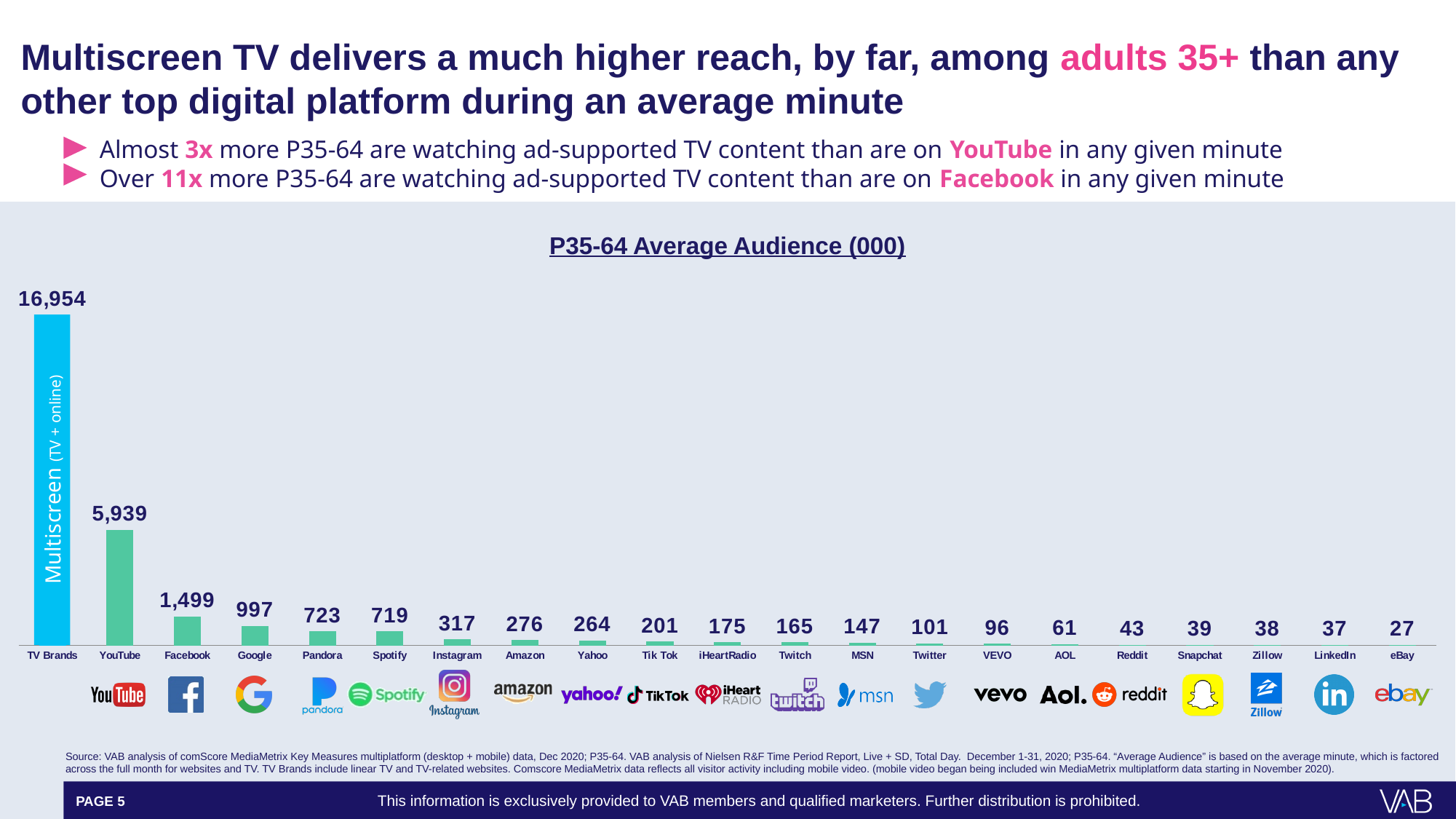
What is the title of the chart? P35-64 Average Audience (000) Which has a larger P35-64 average audience, Instagram or Amazon? Instagram Do the values rise or fall moving from left to right along the x axis? Fall Which category has the lowest P35-64 average audience? eBay Which category has the highest P35-64 average audience? TV Brands What is the difference between the Google value and the Pandora value? 274 What is the P35-64 average audience (000) for Facebook? 1,499 What is the difference between the TV Brands value and the YouTube value? 11,015 How many categories are plotted in the chart? 21 What kind of chart is shown on the slide? Bar chart What is the P35-64 average audience (000) for Tik Tok? 201 What is the P35-64 average audience (000) for YouTube? 5,939